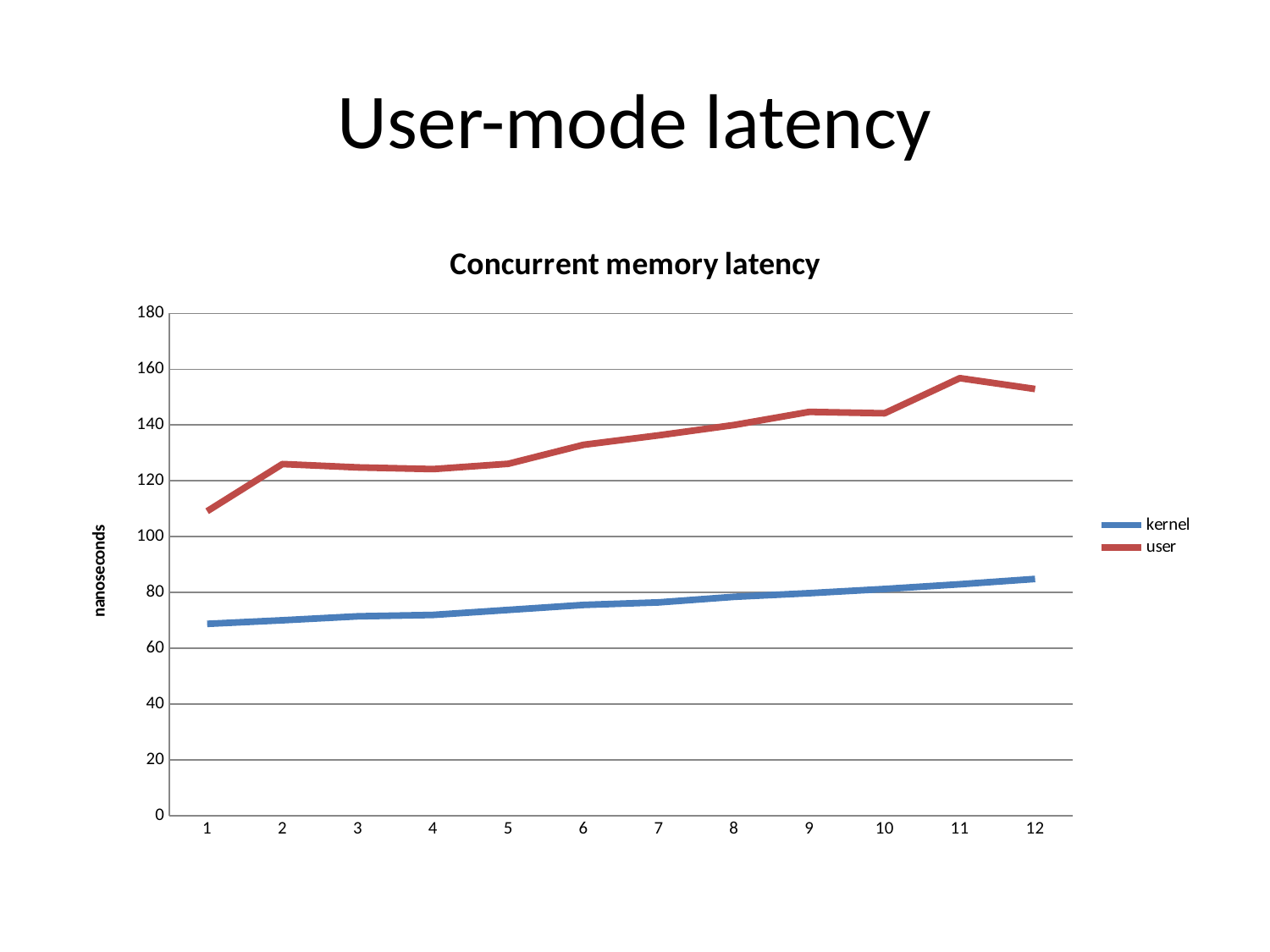
Is the value for the user series at x = 6 greater or less than 120? greater How many series does the legend list? 2 Which series has the larger value at x = 8, kernel or user? user Is the value for the kernel series at x = 1 greater or less than 80? less What type of chart is shown on the slide? line chart Is the value for the user series at x = 1 greater or less than 120? less What is the label on the y axis? nanoseconds At which x value does the user series reach its lowest point? 1 At which x value does the user series reach its highest point? 11 What is the title of the chart? Concurrent memory latency How many points are plotted along the x axis for each series? 12